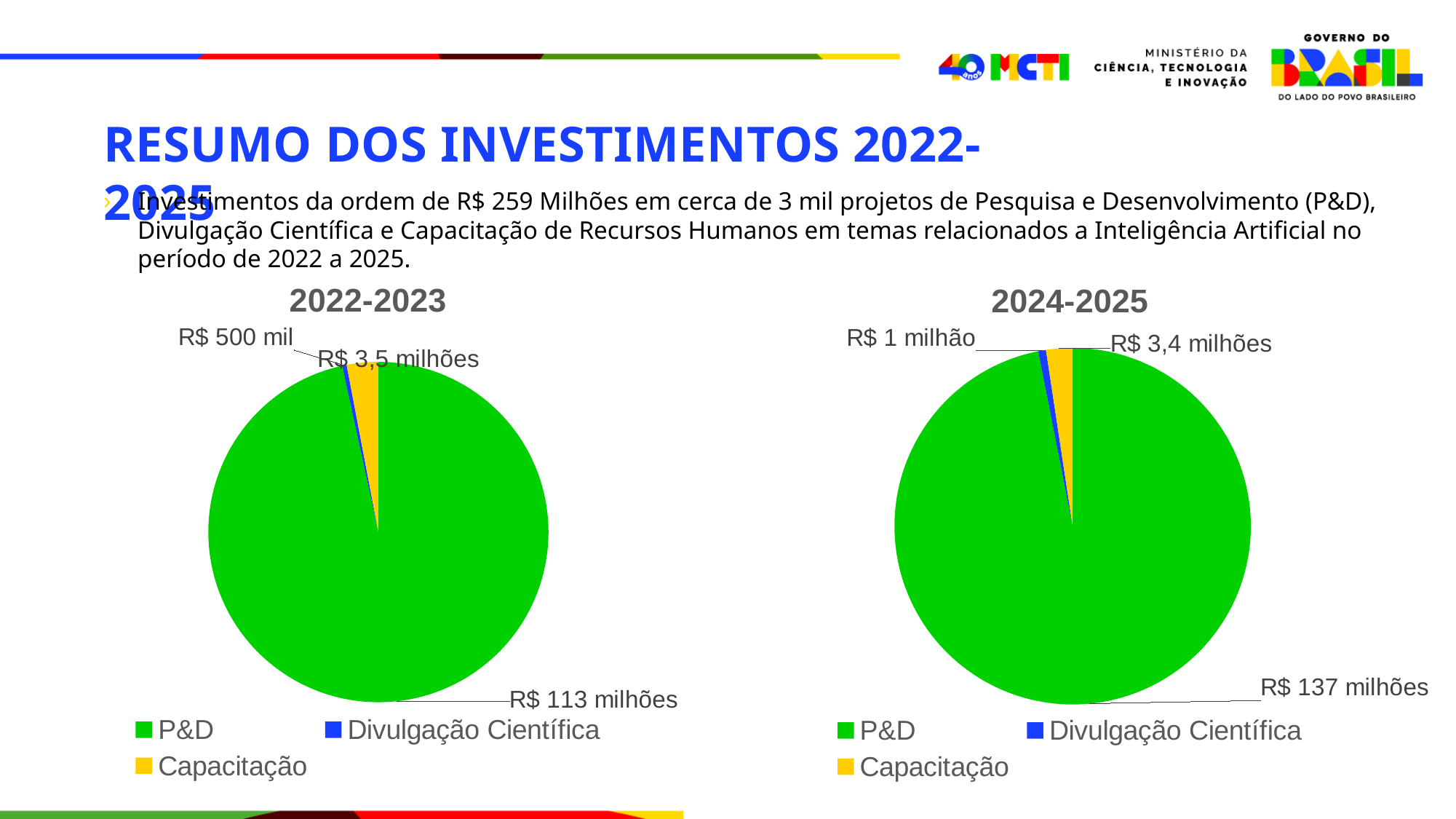
How many categories does the legend of the 2022-2023 pie chart list? 3 In the 2022-2023 pie chart, what is the value for Divulgação Científica? R$ 500 mil In the 2024-2025 pie chart, what is the value for Capacitação? R$ 3,4 milhões What is the difference between the P&D value in the 2024-2025 chart and the P&D value in the 2022-2023 chart? R$ 24 milhões In the 2024-2025 pie chart, what is the value for P&D? R$ 137 milhões In the 2022-2023 pie chart, what is the value for P&D? R$ 113 milhões In the 2022-2023 pie chart, what is the value for Capacitação? R$ 3,5 milhões In the 2022-2023 pie chart, which category has the largest slice? P&D In the 2024-2025 pie chart, which category has the smallest slice? Divulgação Científica Which is larger: Capacitação in the 2022-2023 chart or Capacitação in the 2024-2025 chart? 2022-2023 In the 2024-2025 pie chart, what is the value for Divulgação Científica? R$ 1 milhão What type of chart is used for 2024-2025? Pie chart